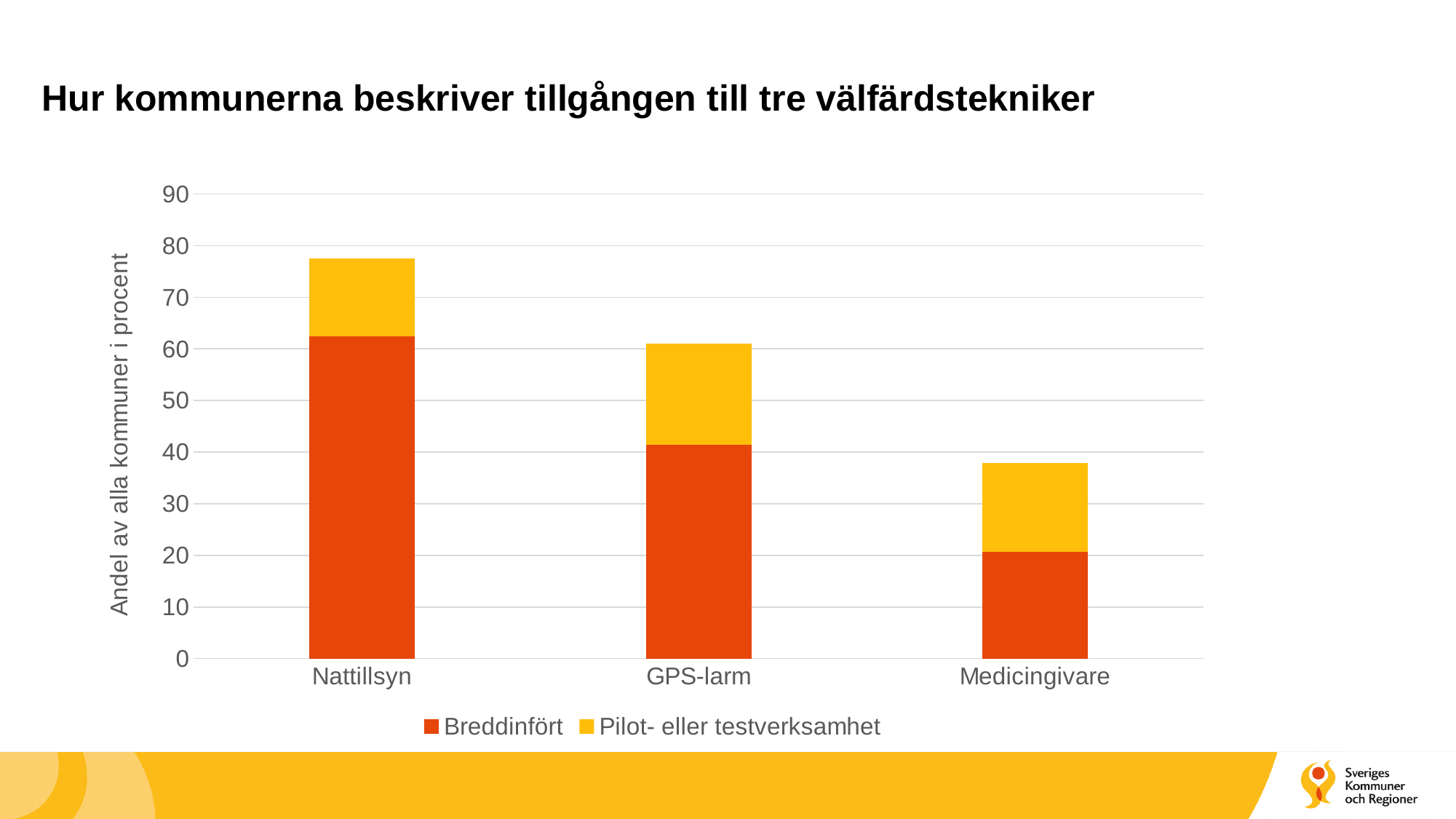
Which category has the largest Breddinfört segment? Nattillsyn Is the total stacked bar for GPS-larm greater or less than 70? less Which category has the shortest stacked bar overall? Medicingivare How many categories are shown on the x axis? 3 How many series does the legend list? 2 Is the total stacked bar for Medicingivare greater or less than 30? greater Which category has the smallest Breddinfört segment? Medicingivare Do the total bar heights rise or fall from Nattillsyn to Medicingivare along the x axis? Fall Which category has the tallest stacked bar overall? Nattillsyn Which is larger, the Breddinfört value for GPS-larm or the Breddinfört value for Medicingivare? GPS-larm What kind of chart is shown on the slide? Stacked bar chart Is the Breddinfört value for Nattillsyn greater or less than 60? greater